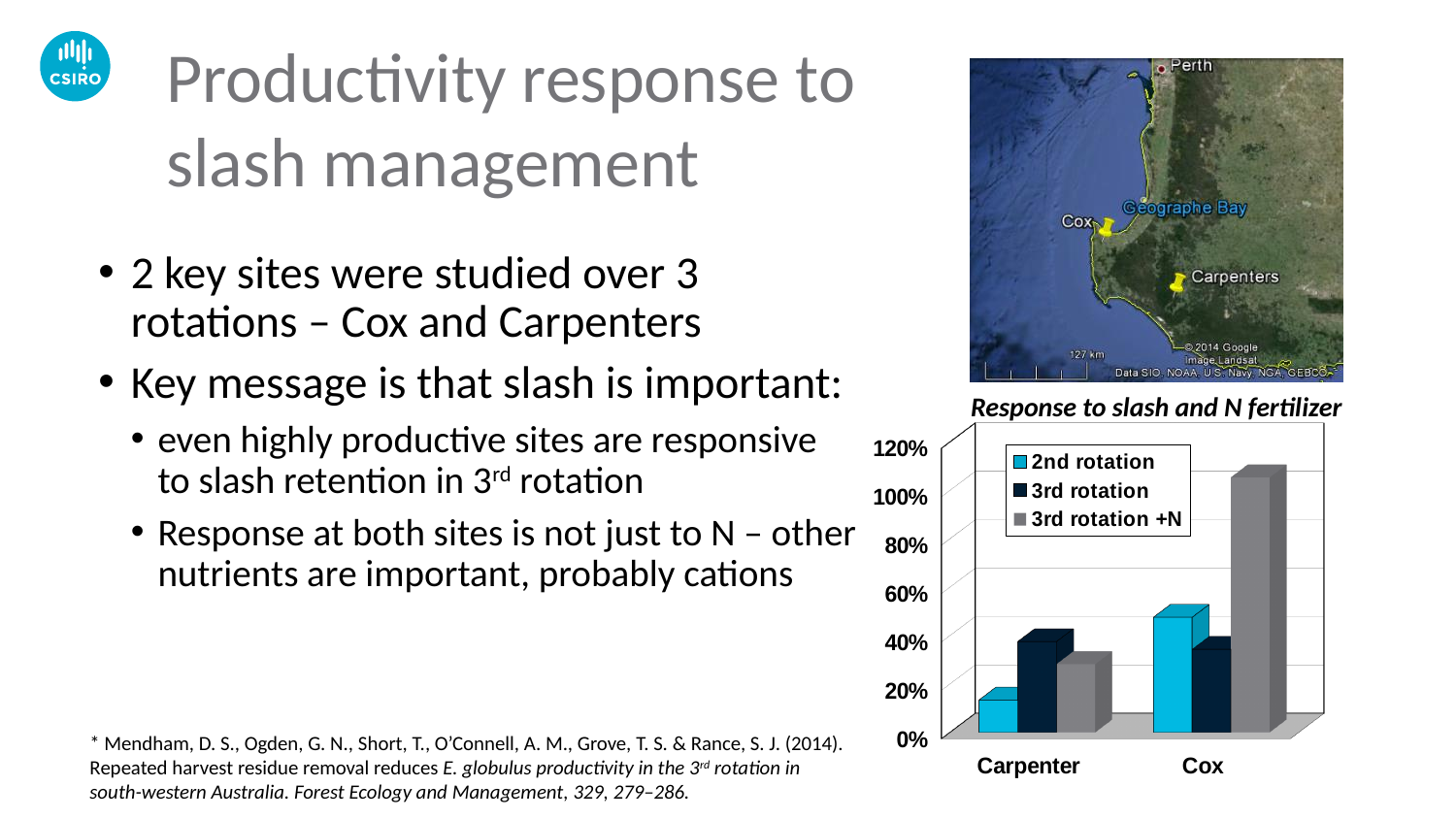
Which legend entry is shown in light blue? 2nd rotation What is the title of the chart? Response to slash and N fertilizer How many site categories are shown on the x axis of the chart? 2 Which series has the lowest value at Cox? 3rd rotation Which site has the larger 2nd rotation value, Carpenter or Cox? Cox Is the value for Cox 3rd rotation +N greater or less than 100%? greater What type of chart is shown on the slide? bar chart Is the value for Carpenter 2nd rotation greater or less than 20%? less How many series does the chart legend list? 3 Which series has the highest value at Carpenter? 3rd rotation Which site and series has the tallest bar in the chart? Cox, 3rd rotation +N Is the value for Cox 2nd rotation greater or less than 40%? greater